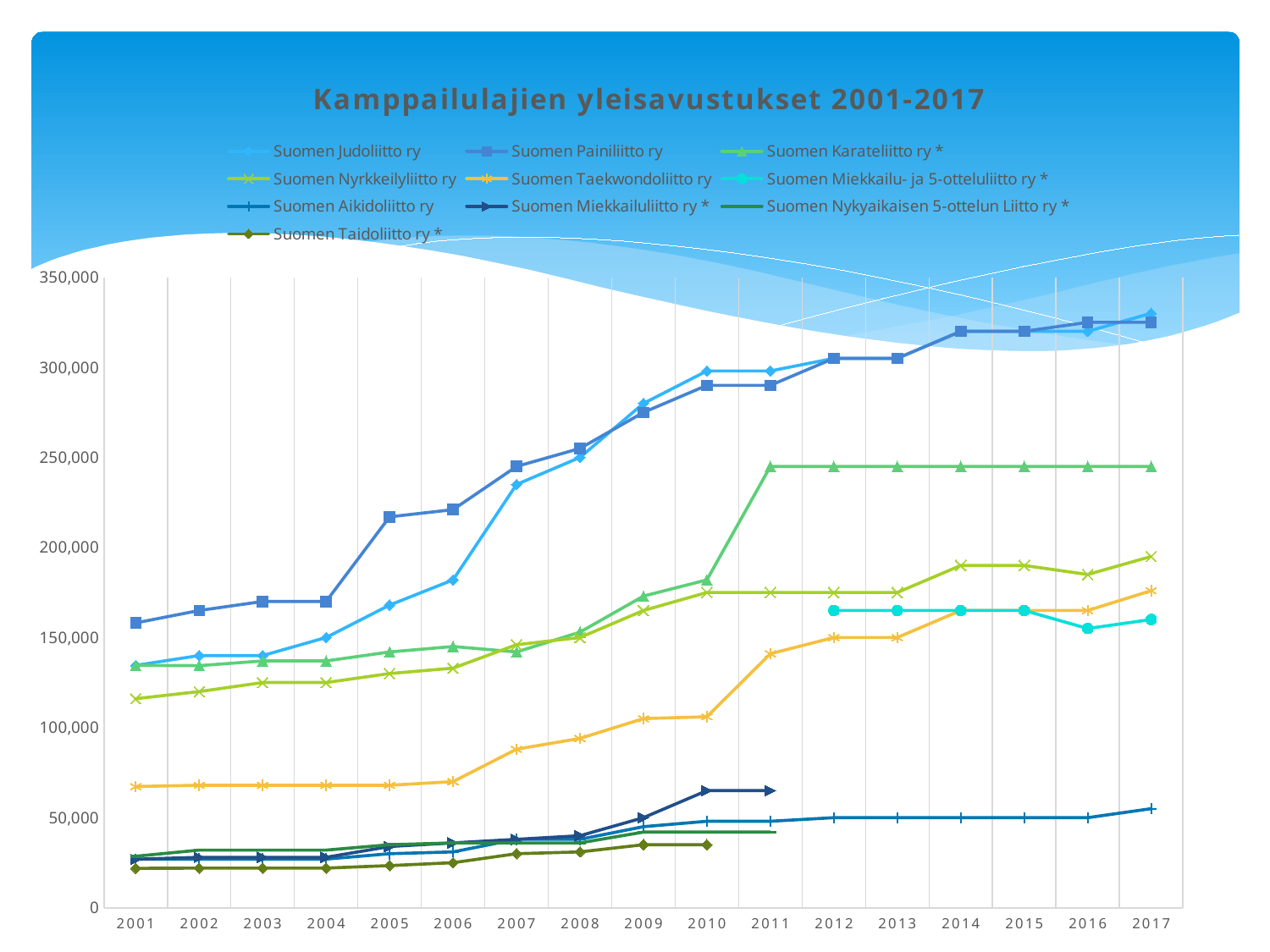
Is the value for Suomen Karateliitto ry * in 2017 greater or less than 200,000? greater Which series has the lowest value in 2010? Suomen Taidoliitto ry * How many series does the legend list? 10 Is the value for Suomen Judoliitto ry in 2010 greater or less than 250,000? greater Is the value for Suomen Aikidoliitto ry in 2017 greater or less than 100,000? less In 2005, which is higher: Suomen Painiliitto ry or Suomen Judoliitto ry? Suomen Painiliitto ry Does the value for Suomen Painiliitto ry generally rise or fall from 2001 to 2017? Rise Which series has the highest value in 2001? Suomen Painiliitto ry How many years are shown on the x axis? 17 What is the title of the chart? Kamppailulajien yleisavustukset 2001-2017 What type of chart is shown on the slide? Line chart